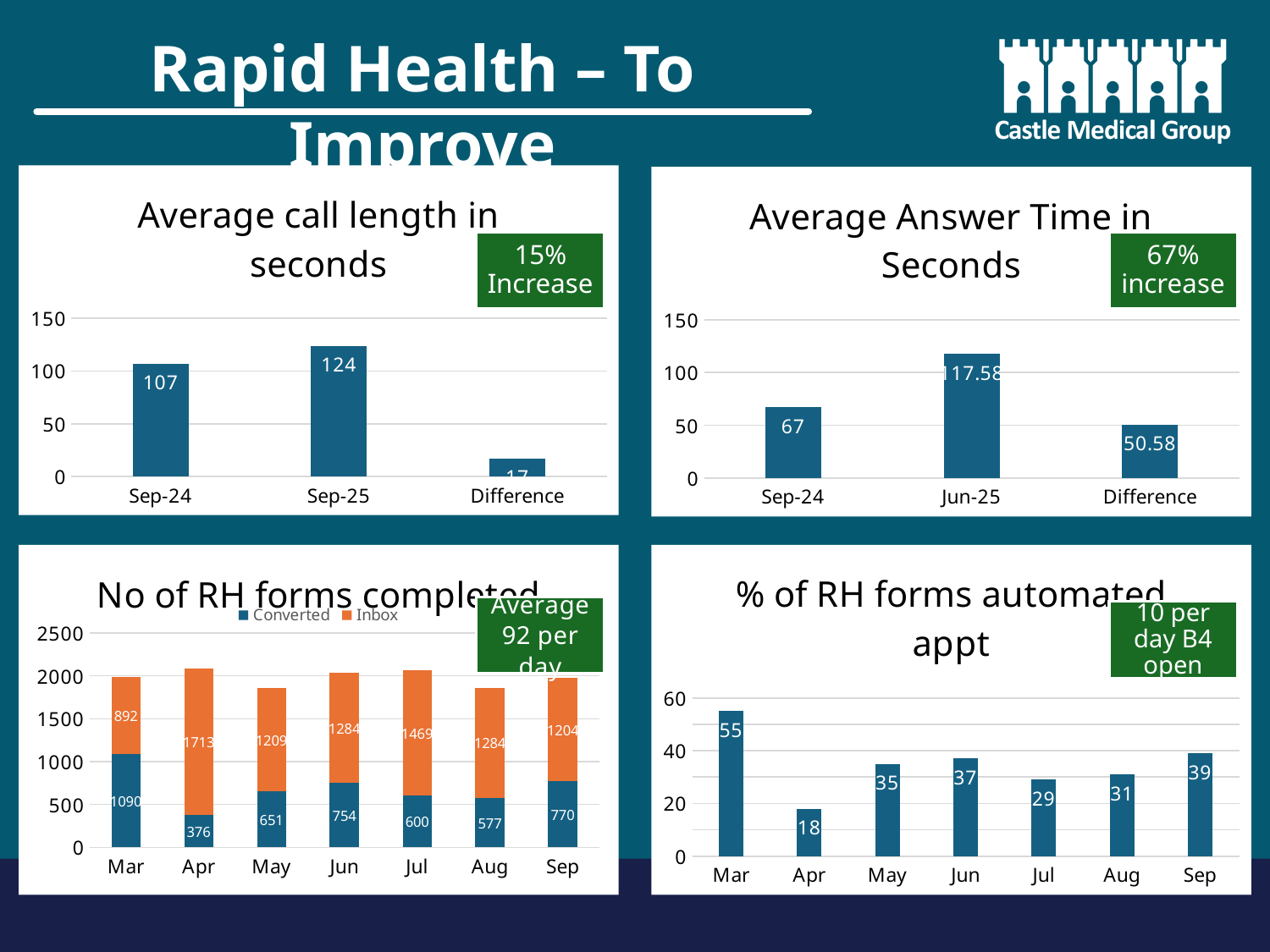
In the 'No of RH forms completed' chart, what is the total of the stacked bar for Mar? 1982 In the 'Average Answer Time in Seconds' chart, is the value for Sep-24 greater or less than 100? less In the 'No of RH forms completed' chart, how many series does the legend list? 2 In the 'Average call length in seconds' chart, what is the value for Sep-25? 124 In the 'No of RH forms completed' chart, what is the Converted value for Apr? 376 In the 'Average Answer Time in Seconds' chart, what is the value for Jun-25? 117.58 In the 'Average Answer Time in Seconds' chart, what is the value labelled Difference? 50.58 In the '% of RH forms automated appt' chart, how many months are plotted? 7 In the 'Average call length in seconds' chart, what is the difference between the Sep-25 and Sep-24 values? 17 In the 'No of RH forms completed' chart, which month has the lowest Converted value? Apr In the '% of RH forms automated appt' chart, which month has the highest value? Mar In the '% of RH forms automated appt' chart, is the value for Jun larger than the value for Jul? Yes